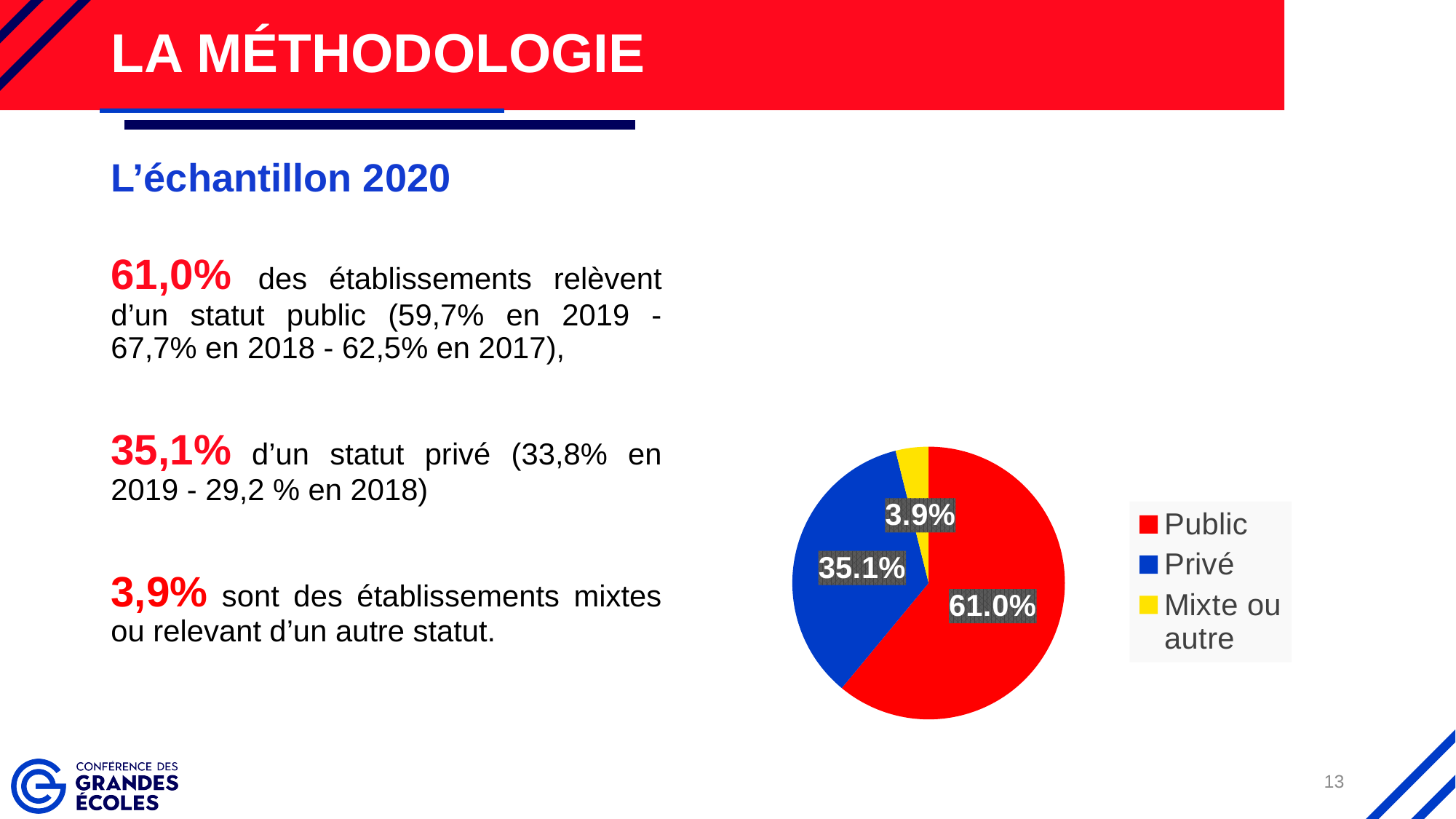
Which category has the largest slice of the pie? Public How many slices does the pie chart have? 3 Which slice is larger, Privé or Mixte ou autre? Privé What is the difference in percentage points between the Public and Privé slices? 25.9 What colour is the Mixte ou autre slice? yellow What kind of chart is shown on the slide? pie chart What colour is the Privé slice? blue What share of the pie does Mixte ou autre represent? 3.9% What share of the pie does Privé represent? 35.1% What share of the pie does Public represent? 61.0% How many entries does the legend list? 3 Which category has the smallest slice of the pie? Mixte ou autre